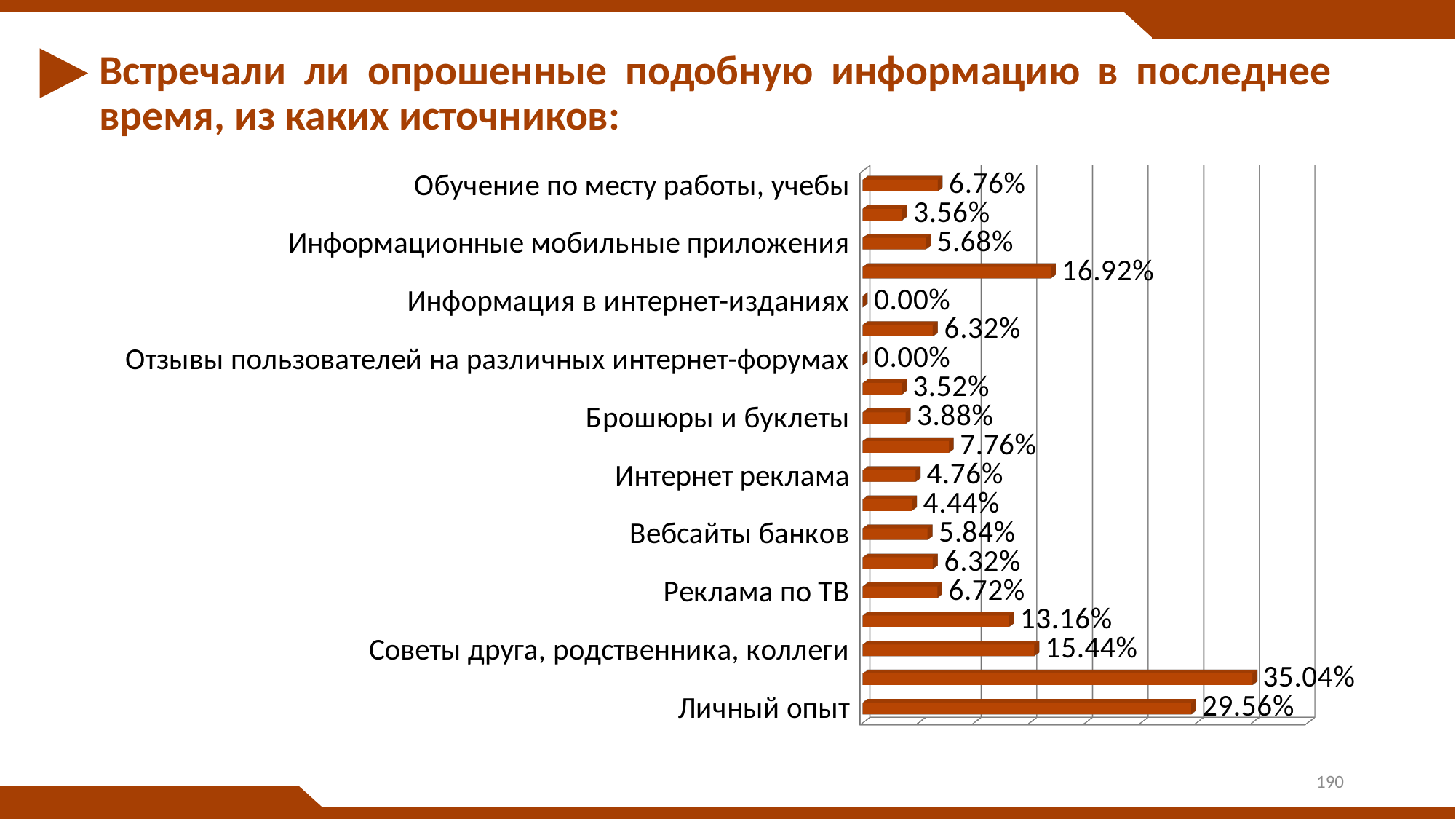
What is the value for Интернет реклама? 4.76% What is the value for Реклама по ТВ? 6.72% What is the largest value shown on the chart? 35.04% What is the difference between the values for Личный опыт and Советы друга, родственника, коллеги? 14.12% What is the value for Информация в интернет-изданиях? 0.00% What is the value for Личный опыт? 29.56% What kind of chart is shown on the slide? Bar chart Which is larger, the value for Личный опыт or the value for Советы друга, родственника, коллеги? Личный опыт What is the value for Советы друга, родственника, коллеги? 15.44% What is the value for Брошюры и буклеты? 3.88% What is the value for Вебсайты банков? 5.84% What is the value for Обучение по месту работы, учебы? 6.76%